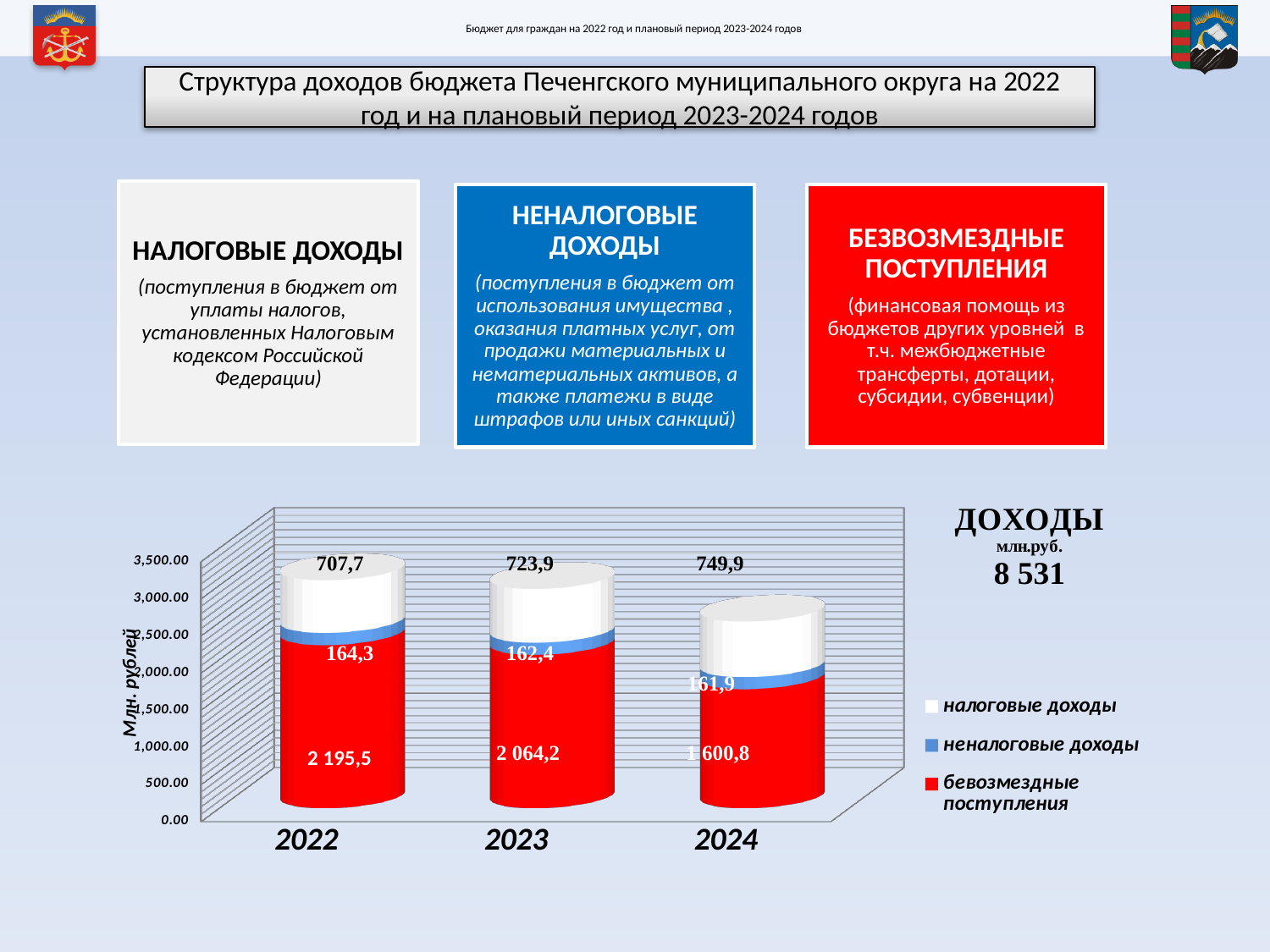
In which year is безвозмездные поступления the lowest? 2024 How many series does the chart legend list? 3 In which year is налоговые доходы the highest? 2024 What is the value of налоговые доходы for 2024? 749,9 What is the total of the stacked bar for 2024? 2 512,6 What is the value of безвозмездные поступления for 2022? 2 195,5 Do the values of безвозмездные поступления rise or fall from 2022 to 2024? fall Which is larger: налоговые доходы in 2022 or in 2023? 2023 What kind of chart is shown on the slide? stacked bar chart What is the difference between безвозмездные поступления in 2022 and 2023? 131,3 What is the value of неналоговые доходы for 2023? 162,4 How many years are shown on the x axis of the chart? 3